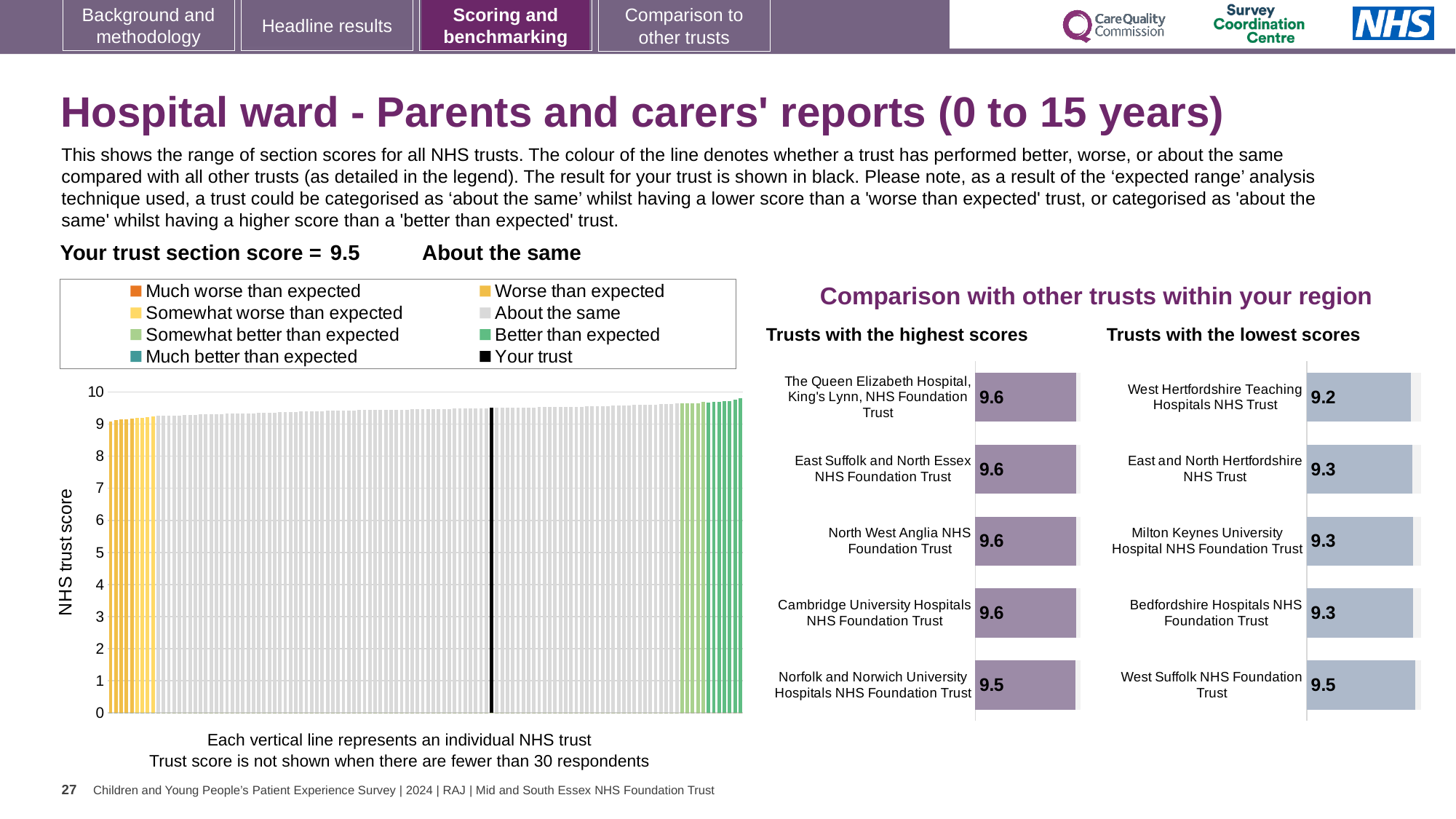
What kind of chart is the large chart on the left showing NHS trust scores? bar chart In the 'Trusts with the highest scores' chart, which trust has the lowest score? Norfolk and Norwich University Hospitals NHS Foundation Trust Which has the higher score: Cambridge University Hospitals NHS Foundation Trust in the 'highest scores' chart or Bedfordshire Hospitals NHS Foundation Trust in the 'lowest scores' chart? Cambridge University Hospitals NHS Foundation Trust In the 'Trusts with the lowest scores' chart, which trust has the highest score? West Suffolk NHS Foundation Trust In the 'Trusts with the lowest scores' chart, what is the score for West Hertfordshire Teaching Hospitals NHS Trust? 9.2 On the left chart, do the trust scores rise or fall from left to right along the x axis? rise On the left chart, what is your trust's section score? 9.5 In the 'Trusts with the highest scores' chart, what is the score for Norfolk and Norwich University Hospitals NHS Foundation Trust? 9.5 In the 'Trusts with the lowest scores' chart, what is the difference between the scores of West Suffolk NHS Foundation Trust and West Hertfordshire Teaching Hospitals NHS Trust? 0.3 In the 'Trusts with the highest scores' chart, how many trusts are shown? 5 What is the label on the y axis of the left chart? NHS trust score How many entries does the legend of the left chart list? 8